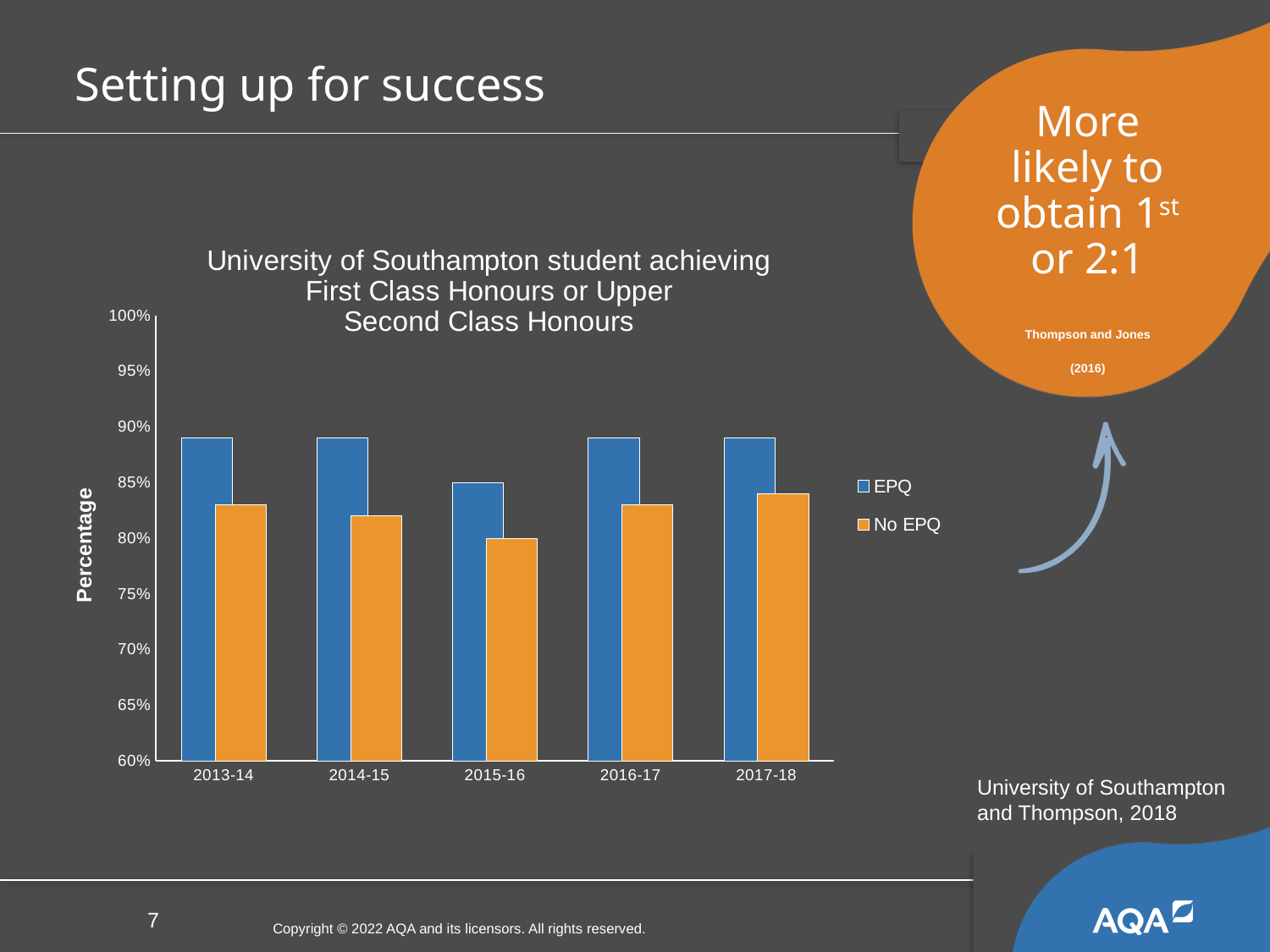
In 2016-17, which is larger: the EPQ value or the No EPQ value? EPQ In which year is the EPQ value lowest? 2015-16 How many series does the chart's legend list? 2 In 2013-14, which is larger: the EPQ value or the No EPQ value? EPQ How many academic years are shown on the x axis of the chart? 5 What kind of chart is shown on the slide? bar chart Is the EPQ value for 2013-14 greater or less than 85%? greater What are the two series named in the chart's legend? EPQ and No EPQ In which year is the No EPQ value lowest? 2015-16 Is the No EPQ value for 2015-16 greater or less than 85%? less Is the No EPQ value for 2014-15 greater or less than 75%? greater What is the label on the chart's vertical axis? Percentage